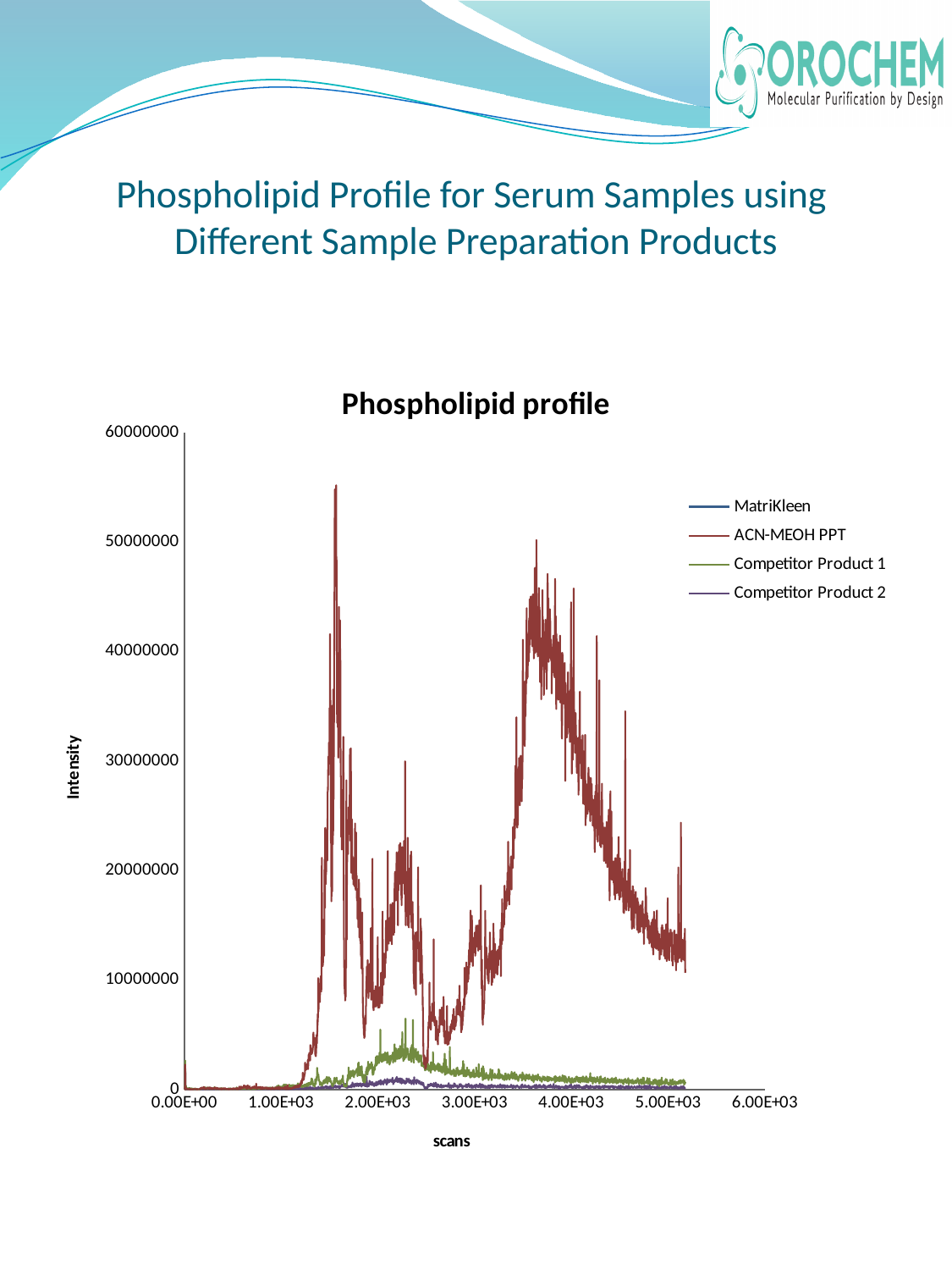
What is the title of the chart? Phospholipid profile What is the largest tick value shown on the y axis of the chart? 60000000 What is the label of the y axis of the chart? Intensity Is the highest value of the MatriKleen series greater or less than 10000000? less Is the peak value of the ACN-MEOH PPT series greater or less than 50000000? greater What kind of chart is shown on the slide? line chart How many series does the legend of the chart list? 4 Which series reaches the highest intensity in the chart? ACN-MEOH PPT Which series has larger intensity values overall, ACN-MEOH PPT or Competitor Product 1? ACN-MEOH PPT What is the largest tick value shown on the x axis of the chart? 6.00E+03 Which series has larger intensity values around 2.00E+03 scans, Competitor Product 1 or Competitor Product 2? Competitor Product 1 Is the highest value of the Competitor Product 1 series greater or less than 10000000? less